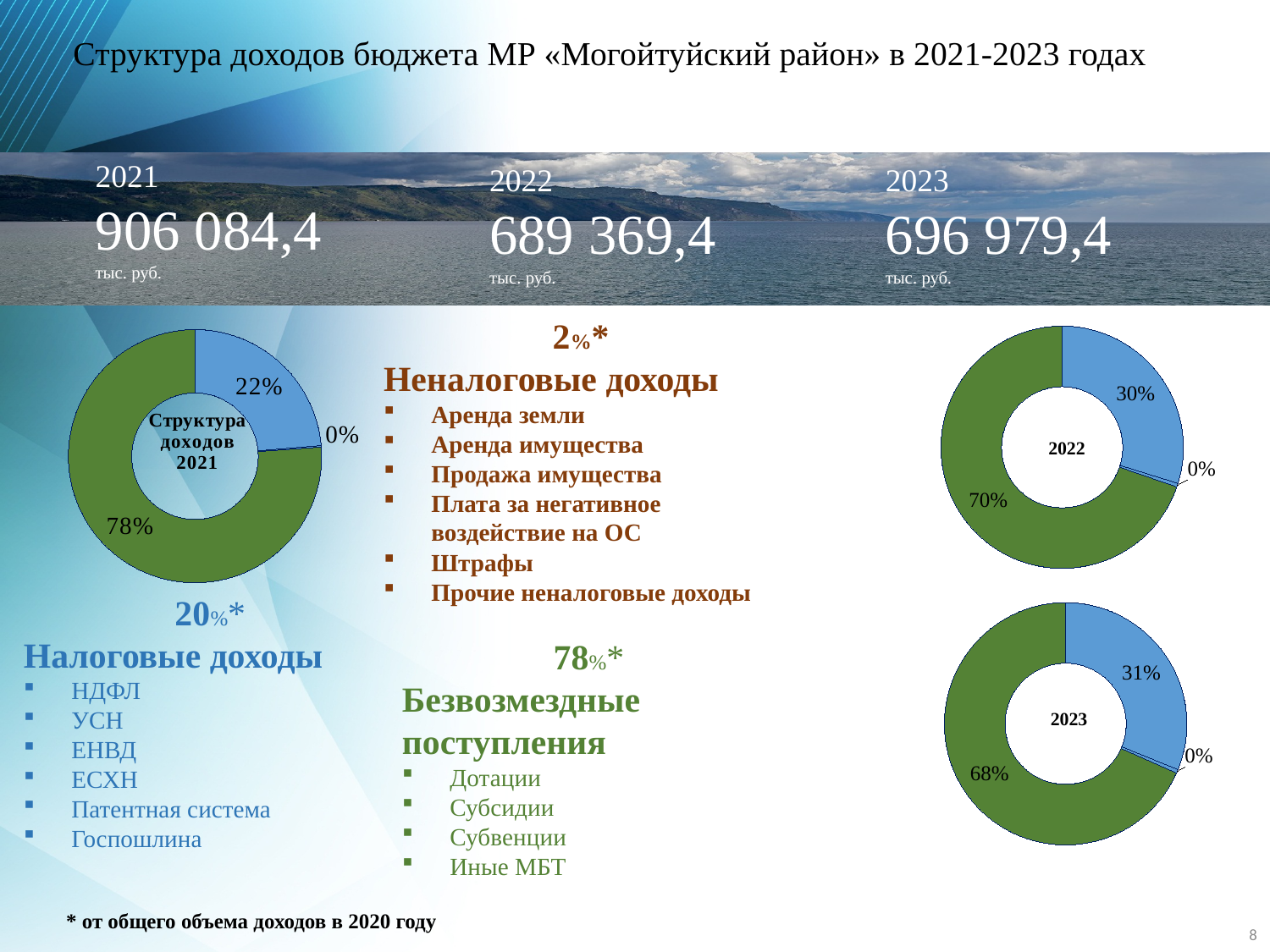
In the doughnut chart labelled "2023", what percentage is shown for the blue slice? 31% How many doughnut charts are shown on the slide? 3 How many percentage labels are shown on the doughnut chart labelled "2023"? 3 In the doughnut chart labelled "Структура доходов 2021", what is the difference between the green slice and the blue slice? 56 percentage points In the doughnut chart labelled "2023", what percentage is shown for the green slice? 68% In the doughnut chart labelled "Структура доходов 2021", what percentage is shown for the green slice? 78% What type of chart is used to show the revenue structure for 2021, 2022 and 2023? Doughnut (pie) chart In the doughnut chart labelled "2022", what percentage is shown for the blue slice? 30% In the doughnut chart labelled "2022", what percentage is shown for the green slice? 70% In the doughnut chart labelled "2023", which slice is the largest? The green slice (68%) In the doughnut chart labelled "Структура доходов 2021", what percentage is shown for the blue slice? 22% In the doughnut chart labelled "2022", which is larger, the blue slice or the green slice? The green slice